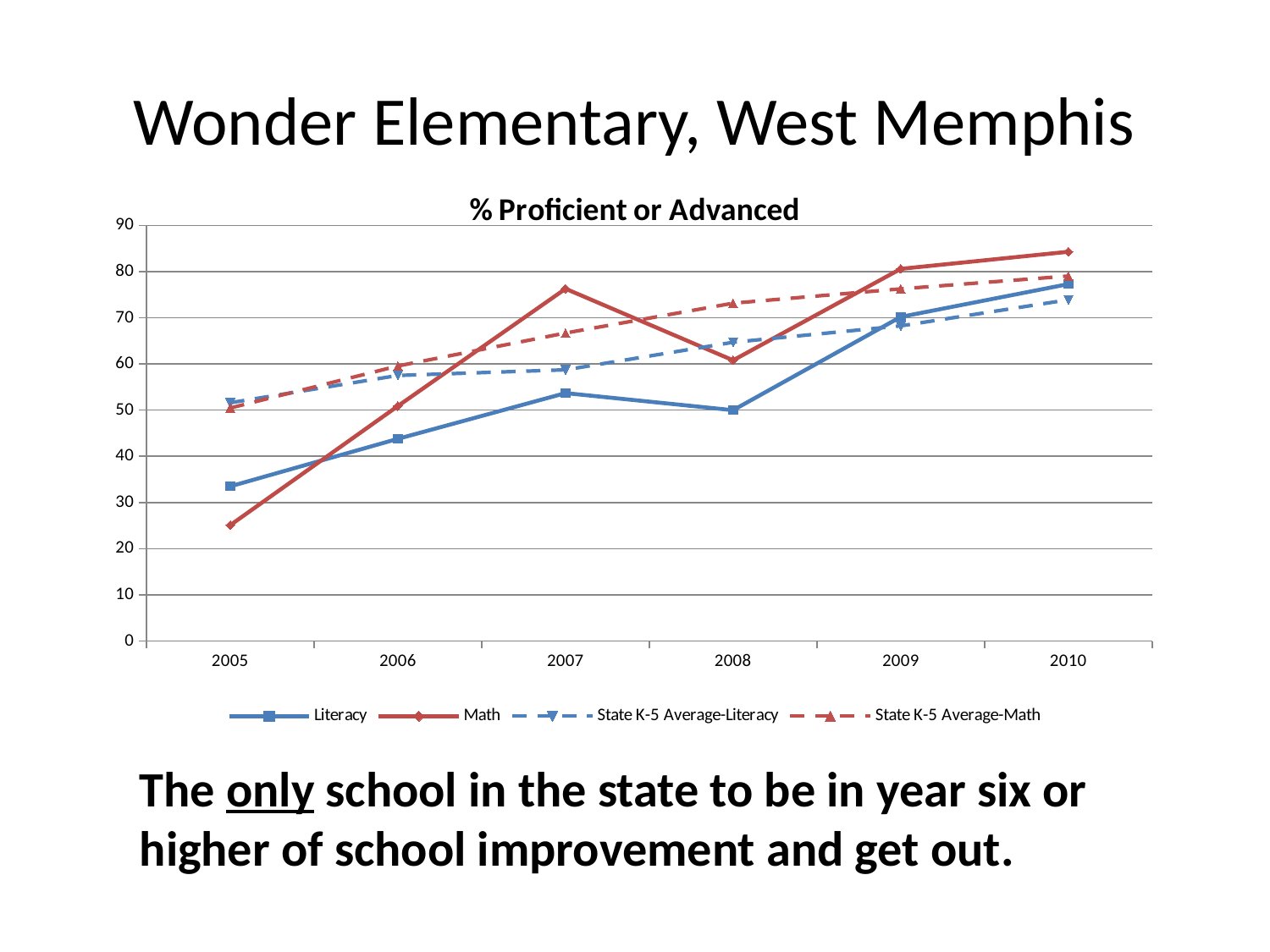
How many years are plotted along the x axis? 6 What is the title of the chart? % Proficient or Advanced How many series does the legend list? 4 Is the Literacy value for 2010 greater or less than 70? greater What kind of chart is shown on the slide? line chart Does the State K-5 Average-Math series rise or fall from 2005 to 2010? rise In which year is the Literacy series at its lowest? 2005 In which year is the Math series at its lowest? 2005 In which year is the Math series at its highest? 2010 In 2007, which is larger: Math or Literacy? Math Is the Math value for 2005 greater or less than 30? less In 2008, which is larger: Math or State K-5 Average-Math? State K-5 Average-Math